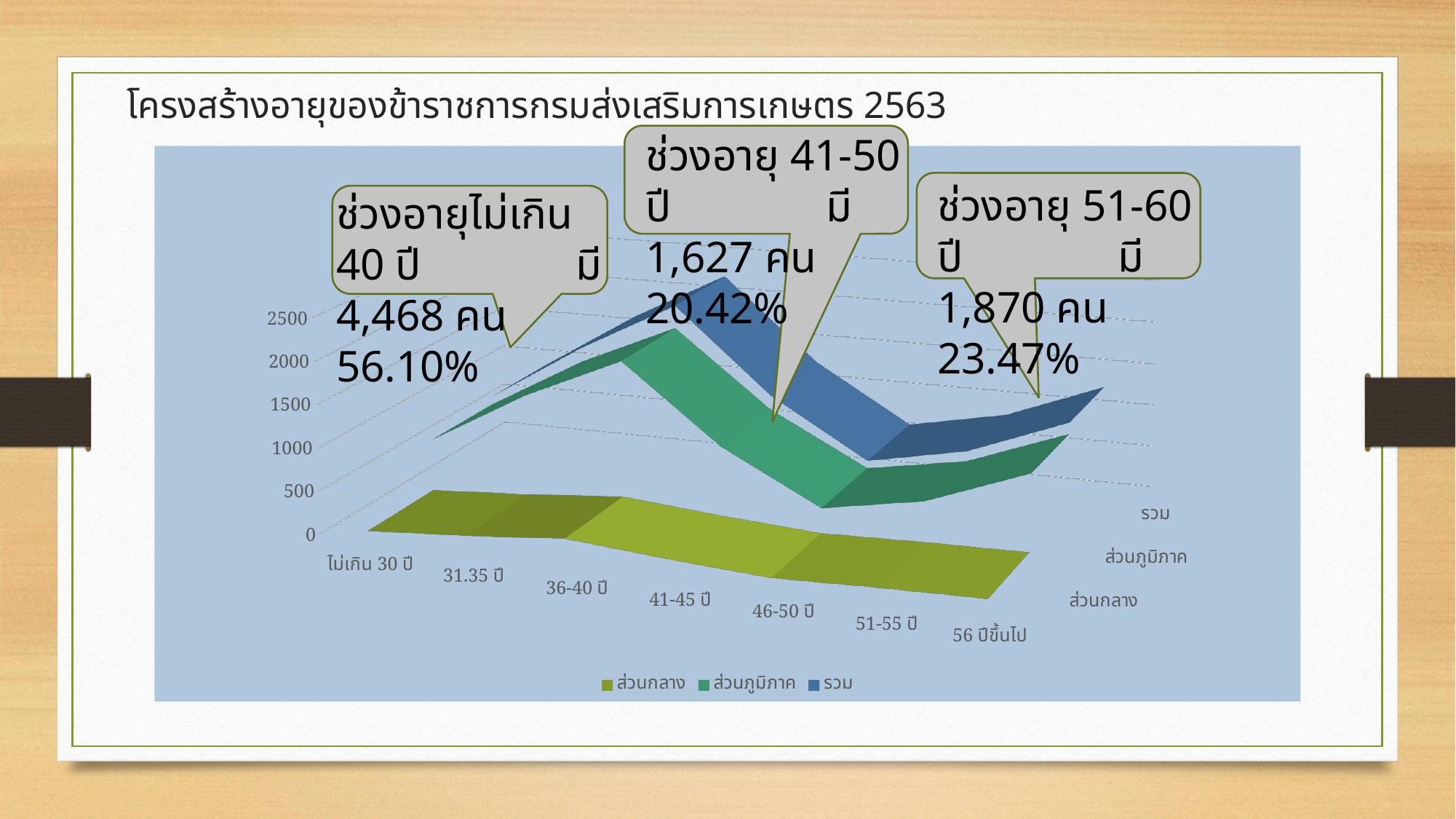
According to the callout, how many people are in the age group 41-50 ปี? 1,627 คน What are the three series named in the chart legend? ส่วนกลาง, ส่วนภูมิภาค, รวม How many age-group categories are shown along the x axis of the chart? 7 According to the callout, how many people are in the age group ไม่เกิน 40 ปี? 4,468 คน At which x-axis category does the รวม series reach its highest point? 36-40 ปี According to the callout, what percentage does the age group ไม่เกิน 40 ปี represent? 56.10% What is the title of the slide above the chart? โครงสร้างอายุของข้าราชการกรมส่งเสริมการเกษตร 2563 What is the difference in number of people between the 51-60 ปี group and the 41-50 ปี group, according to the callouts? 243 คน What kind of chart is shown on the slide? 3D line chart How many series does the chart legend list? 3 According to the callout, what percentage does the age group 51-60 ปี represent? 23.47% Which age group has more people according to the callouts: 41-50 ปี or 51-60 ปี? 51-60 ปี